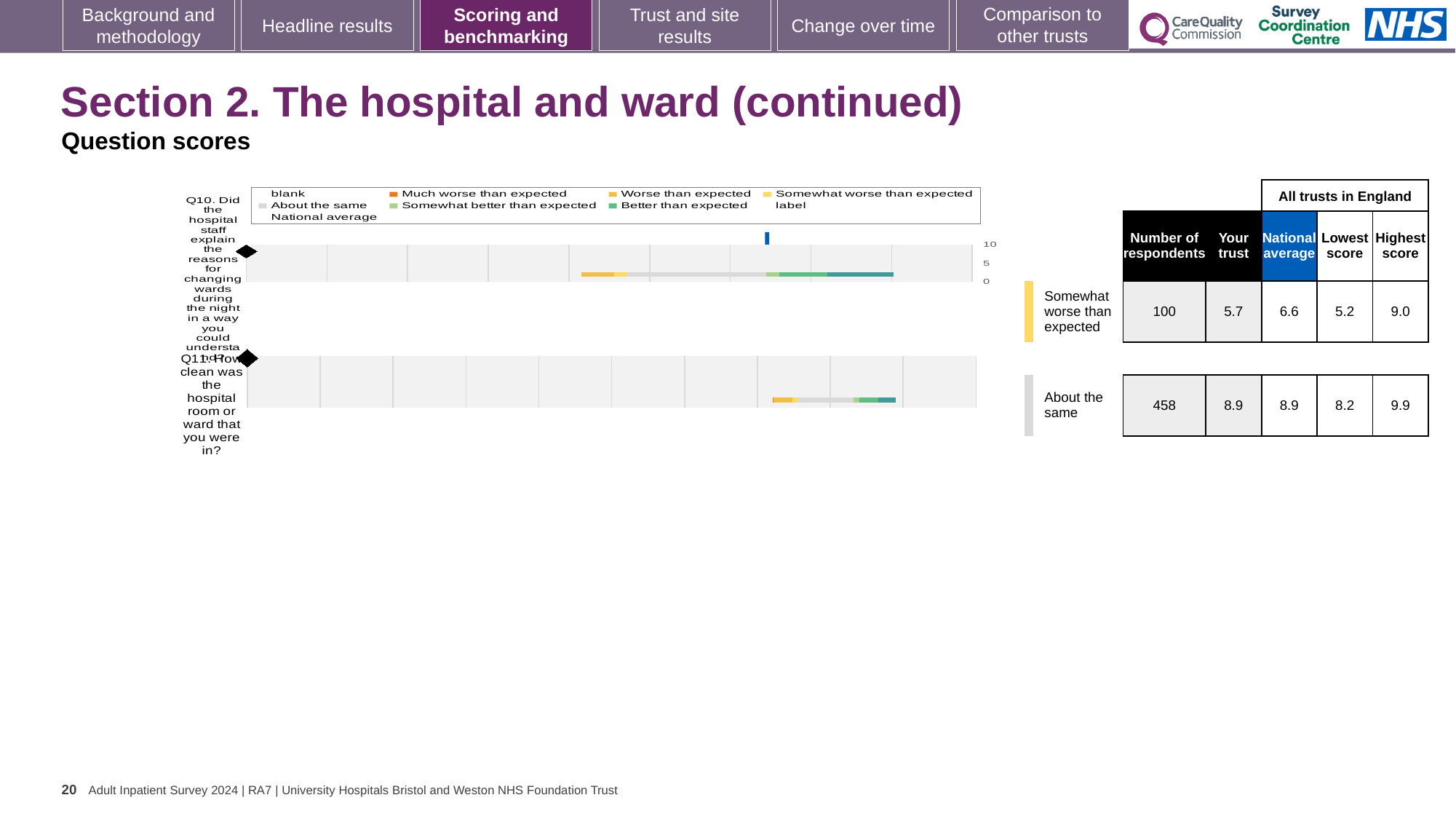
Which benchmarking category is the trust's Q11 score placed in? About the same What kind of chart is used to show the question scores for Q10 and Q11? bar chart How many respondents answered Q11? 458 How many questions are plotted in the question scores chart? 2 What is the national average score for Q10? 6.6 What is the lowest score among all trusts in England for Q10? 5.2 Which benchmarking category is the trust's Q10 score placed in? Somewhat worse than expected What is the 'Your trust' score for Q10 (explaining reasons for changing wards during the night)? 5.7 Which question has the higher 'Your trust' score, Q10 or Q11? Q11 What is the difference between the highest and lowest scores for Q11 across all trusts in England? 1.7 What is the 'Your trust' score for Q11 (how clean was the hospital room or ward)? 8.9 By how much is the national average for Q10 higher than the trust's score for Q10? 0.9